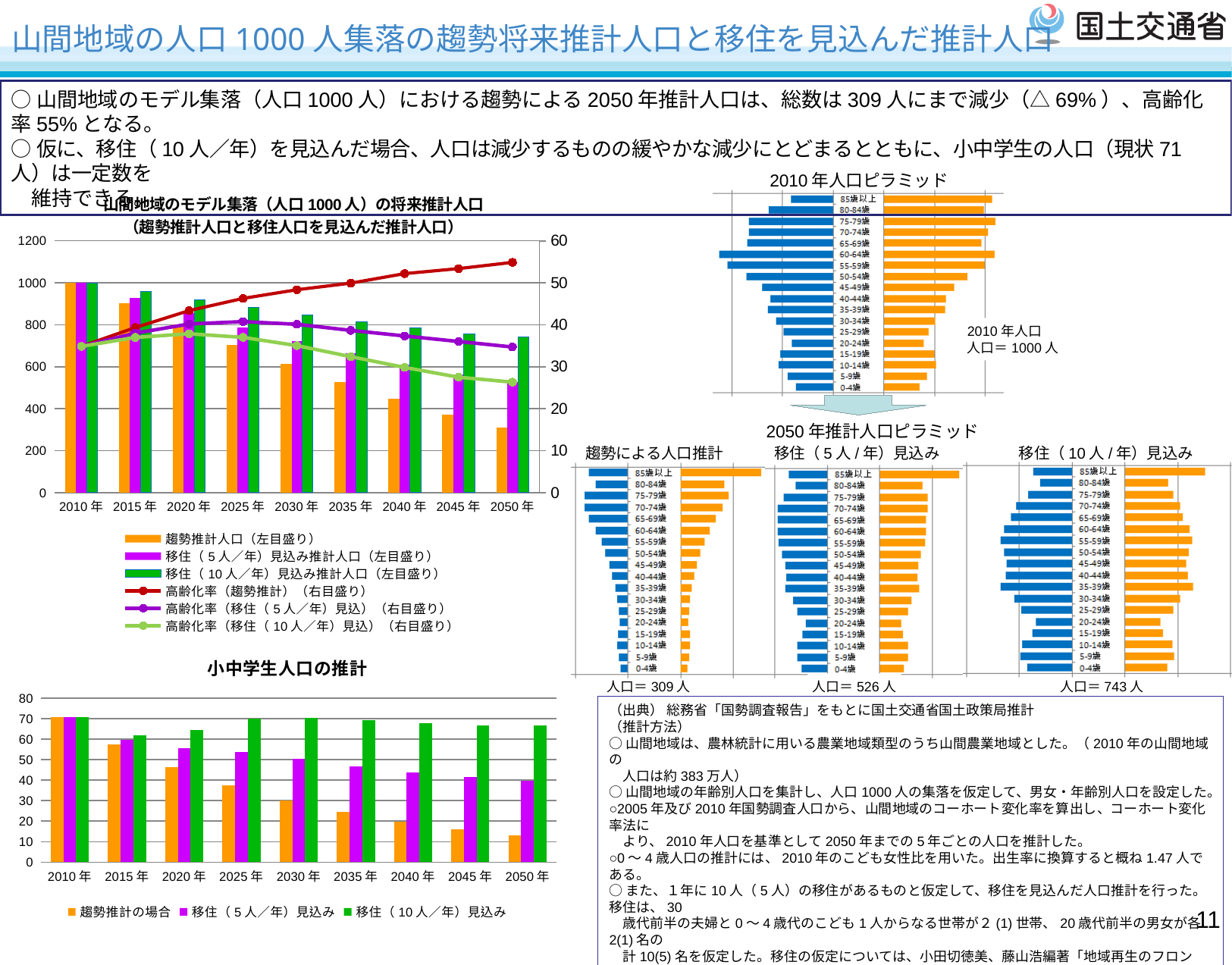
In the top-left chart 山間地域のモデル集落（人口1000人）の将来推計人口, is the value for 趨勢推計人口 in 2050年 greater or less than 400? less In the 2050年推計人口ピラミッド section, what population is shown under the 移住（10人/年）見込み pyramid? 人口＝743人 In the top-left chart 山間地域のモデル集落（人口1000人）の将来推計人口, which series has the lowest bar in 2050年? 趨勢推計人口（左目盛り） In the chart titled 小中学生人口の推計, how many year categories are shown on the x axis? 9 In the chart titled 小中学生人口の推計, which series has the highest value in 2040年? 移住（10人／年）見込み What kind of chart is the chart titled 小中学生人口の推計? Bar chart In the chart titled 小中学生人口の推計, is the value for 趨勢推計の場合 in 2050年 greater or less than 20? less In the top-left chart 山間地域のモデル集落（人口1000人）の将来推計人口, how many series does the legend list? 6 In the chart titled 小中学生人口の推計, does the 趨勢推計の場合 series rise or fall from 2010年 to 2050年? Fall In the chart titled 小中学生人口の推計, is the value for 移住（10人／年）見込み in 2030年 greater or less than 60? greater In the chart titled 小中学生人口の推計, how many series does the legend list? 3 In the top-left chart 山間地域のモデル集落（人口1000人）の将来推計人口, does the 高齢化率（趨勢推計） line rise or fall from 2010年 to 2050年? Rise